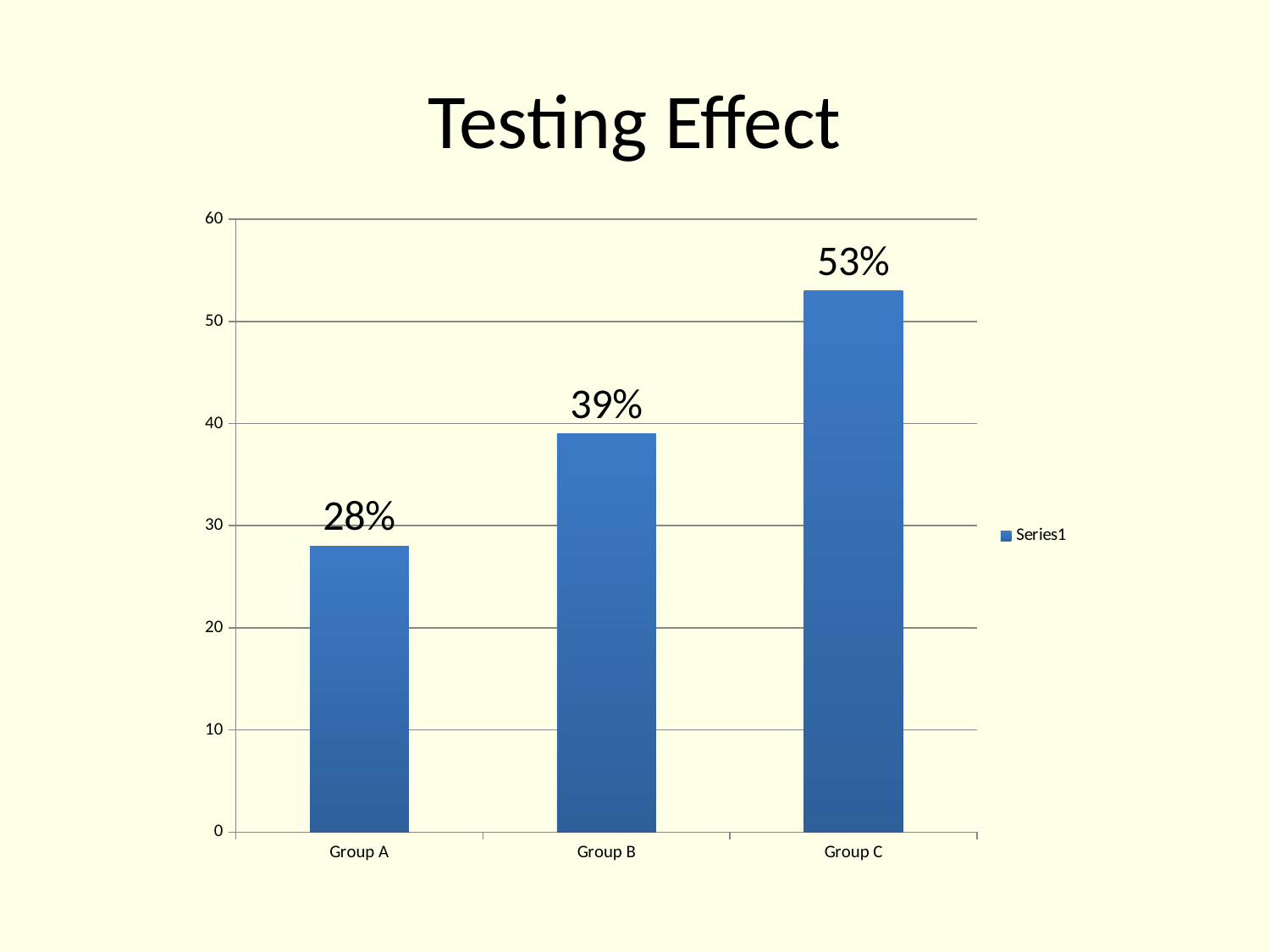
Which is larger, the value for Group B or the value for Group C? Group C Do the values rise or fall from Group A to Group C? rise What is the difference between the values for Group C and Group A? 25% What is the value for Group B? 39% What is the value for Group C? 53% How many groups are shown on the chart? 3 What kind of chart is shown on the slide? bar chart Is the value for Group B greater or less than 40? less Which group has the lowest value? Group A What is the difference between the values for Group B and Group A? 11% Which group has the highest value? Group C What is the value for Group A? 28%